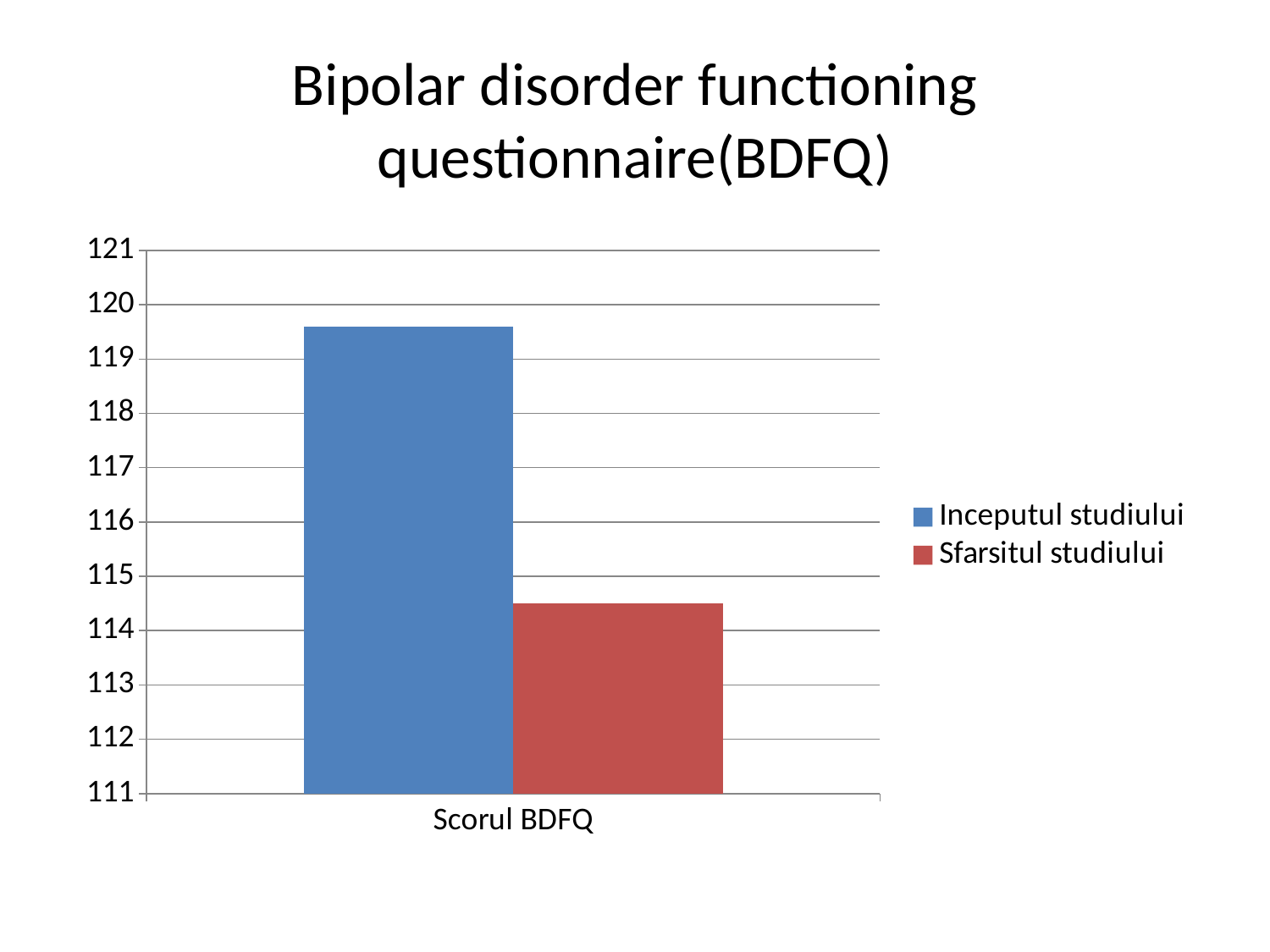
What is the label of the category on the x axis? Scorul BDFQ Is the value for Sfarsitul studiului greater or less than 114? greater What kind of chart is shown on the slide? bar chart How many series does the legend list? 2 What colour is the bar for Sfarsitul studiului? red How many categories are shown on the x axis? 1 Is the value for Inceputul studiului greater or less than 119? greater Is the value for Inceputul studiului greater or less than 120? less What is the title of the slide? Bipolar disorder functioning questionnaire(BDFQ) Which series has the lowest value for Scorul BDFQ? Sfarsitul studiului Which series has the larger value for Scorul BDFQ, Inceputul studiului or Sfarsitul studiului? Inceputul studiului